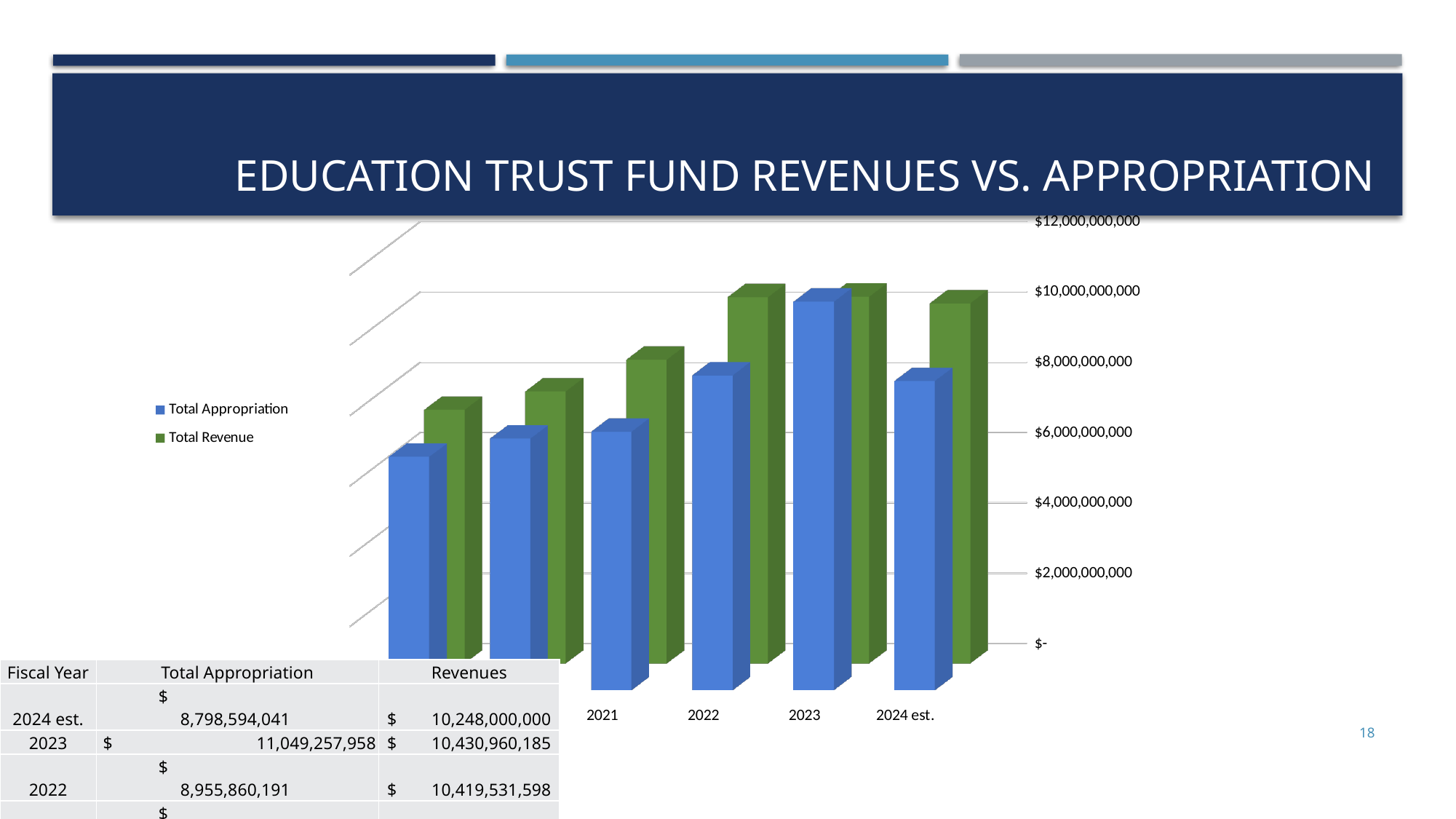
Which fiscal year has the highest Total Appropriation bar? 2023 How many fiscal year categories are plotted on the x axis of the chart? 6 What is the title of the chart on the slide? Education Trust Fund Revenues vs. Appropriation Is the Total Appropriation value for 2021 greater or less than $8,000,000,000? less What kind of chart is shown on the slide? Bar chart Does Total Appropriation rise or fall from 2021 to 2023? rise Which is larger: Total Appropriation for 2023 or Total Appropriation for 2024 est.? 2023 Is the Total Revenue value for 2024 est. greater or less than $8,000,000,000? greater How many series does the chart legend list? 2 For 2021, which is larger: Total Appropriation or Total Revenue? Total Revenue